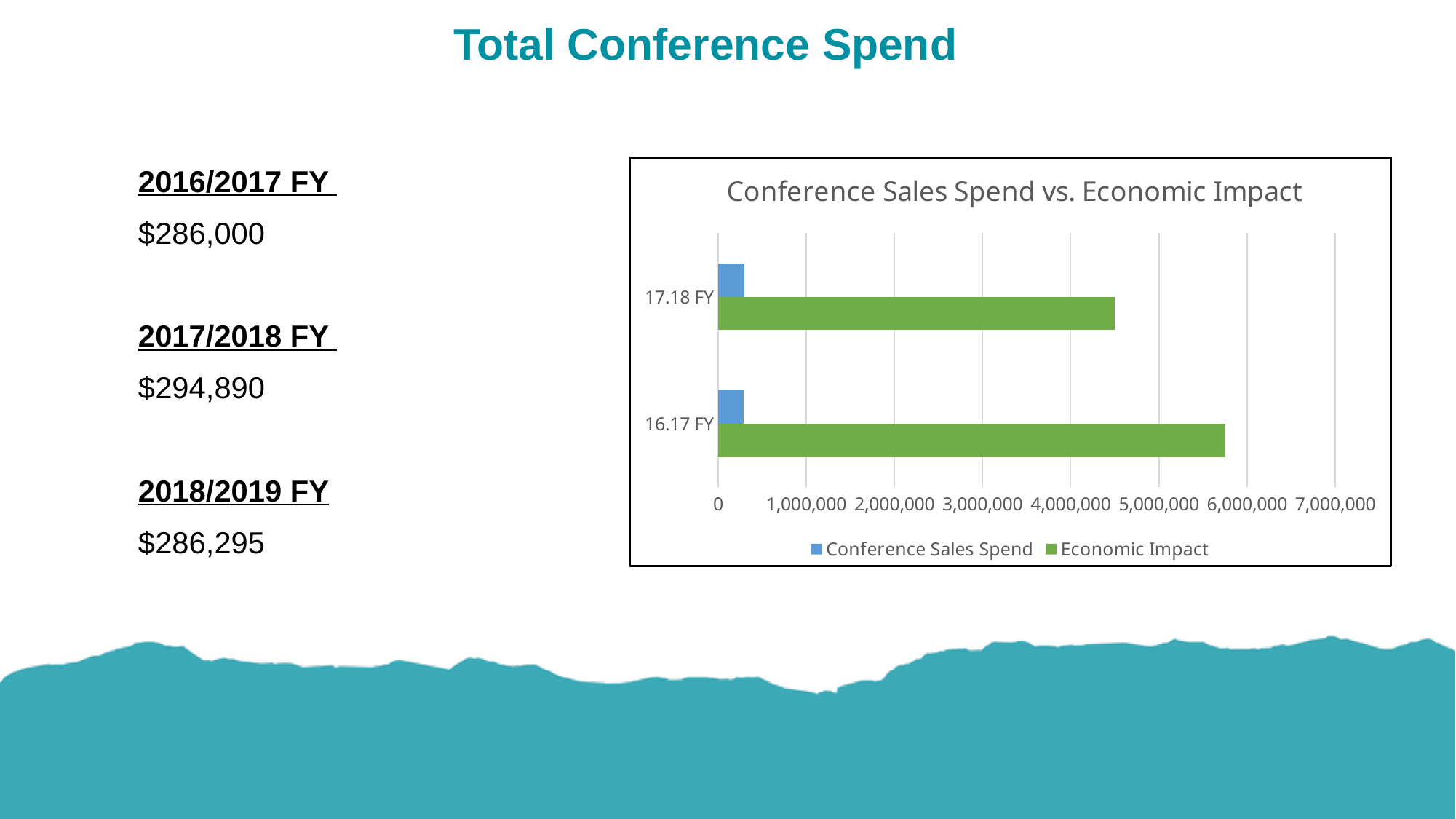
What kind of chart is shown on the slide? bar chart Which series is shown in green on the chart? Economic Impact How many series does the chart's legend list? 2 Is the Economic Impact value for 16.17 FY greater or less than 5,000,000? greater Which fiscal year has the lower Economic Impact value? 17.18 FY What is the title of the chart? Conference Sales Spend vs. Economic Impact How many fiscal year categories are plotted on the chart? 2 Is the Economic Impact value for 17.18 FY greater or less than 4,000,000? greater For 17.18 FY, which is larger: Conference Sales Spend or Economic Impact? Economic Impact Which fiscal year has the higher Economic Impact value? 16.17 FY Is the Economic Impact value for 17.18 FY greater or less than 5,000,000? less